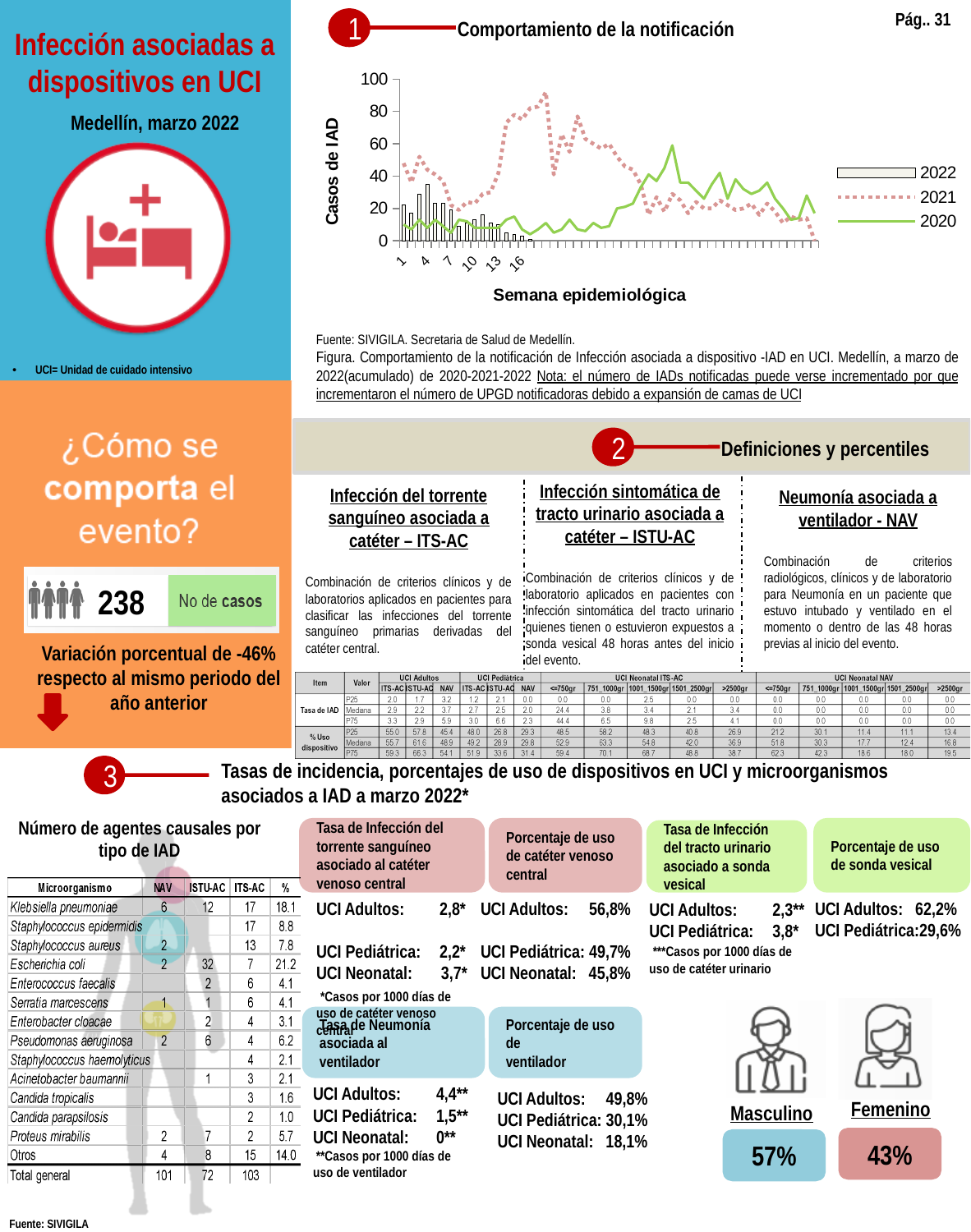
In the 'Comportamiento de la notificación' chart, which series has the higher peak, 2020 or 2021? 2021 What is the title of the chart at the top of the slide? Comportamiento de la notificación In the 'Comportamiento de la notificación' chart, is the peak value of the 2021 series greater or less than 80? greater In the 'Comportamiento de la notificación' chart, is the highest 2022 bar greater or less than 60? less What kind of chart is 'Comportamiento de la notificación'? A combined bar and line chart In the 'Comportamiento de la notificación' chart, is the peak value of the 2020 series greater or less than 40? greater What is the label of the horizontal axis of the 'Comportamiento de la notificación' chart? Semana epidemiológica In the 'Comportamiento de la notificación' chart, does the 2021 line end higher or lower than it starts? lower In the 'Comportamiento de la notificación' chart, which series is drawn as bars? 2022 How many series does the legend of the 'Comportamiento de la notificación' chart list? 3 In the 'Comportamiento de la notificación' chart, which series reaches the highest value? 2021